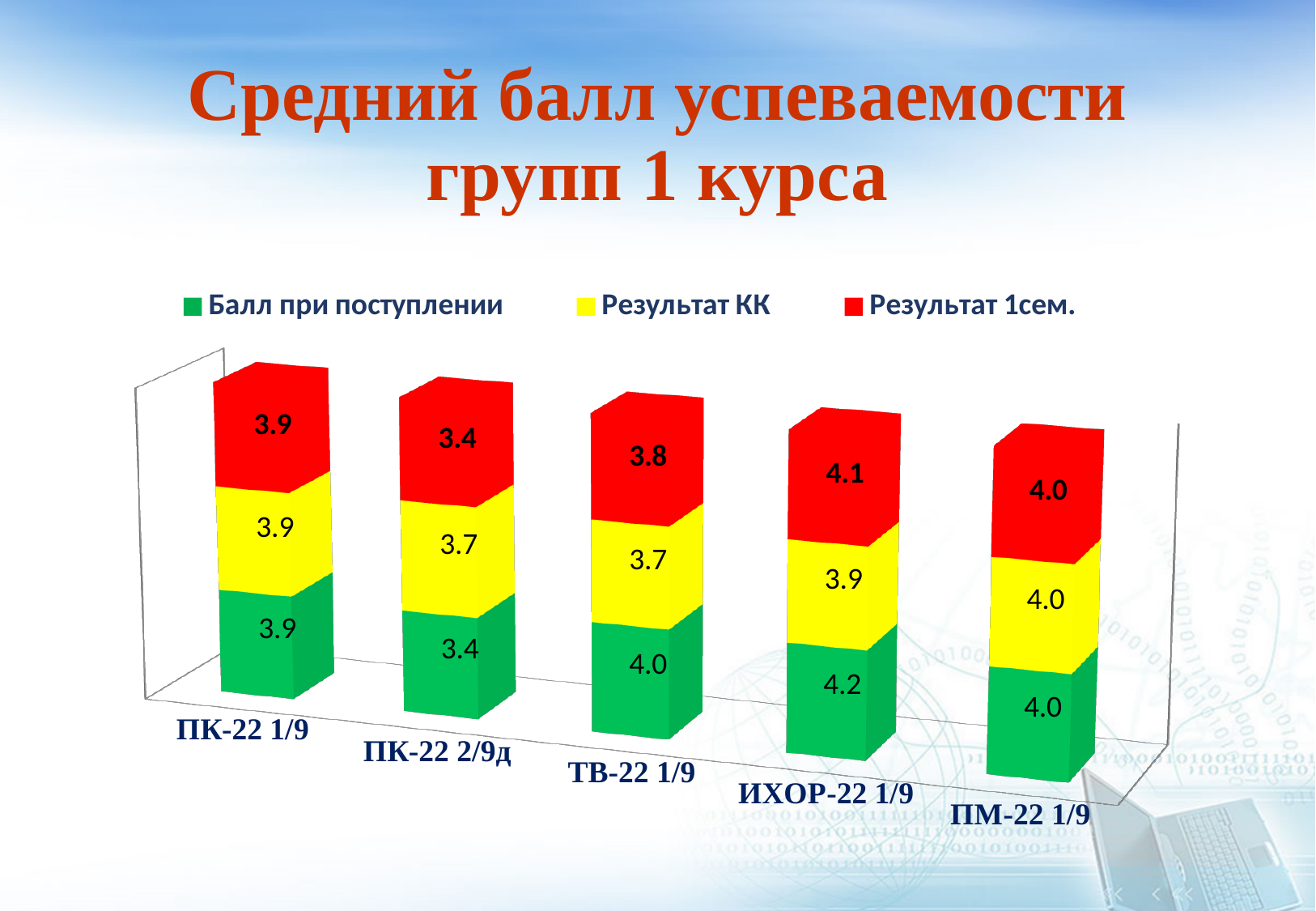
What kind of chart is shown on the slide? stacked bar chart What is the value of "Результат КК" for ТВ-22 1/9? 3.7 What is the difference between the "Результат 1сем." values for ИХОР-22 1/9 and ПК-22 2/9д? 0.7 How many groups (categories) are shown on the x axis? 5 What is the total of the stacked bar for ПМ-22 1/9? 12.0 Which group has the lowest "Результат 1сем." value? ПК-22 2/9д Which is larger: the "Результат КК" value for ПМ-22 1/9 or for ПК-22 2/9д? ПМ-22 1/9 What is the value of "Балл при поступлении" for ПК-22 2/9д? 3.4 Which group has the highest "Балл при поступлении" value? ИХОР-22 1/9 What is the value of "Результат 1сем." for ИХОР-22 1/9? 4.1 How many series does the legend list? 3 Which colour represents the "Результат КК" series in the legend? yellow